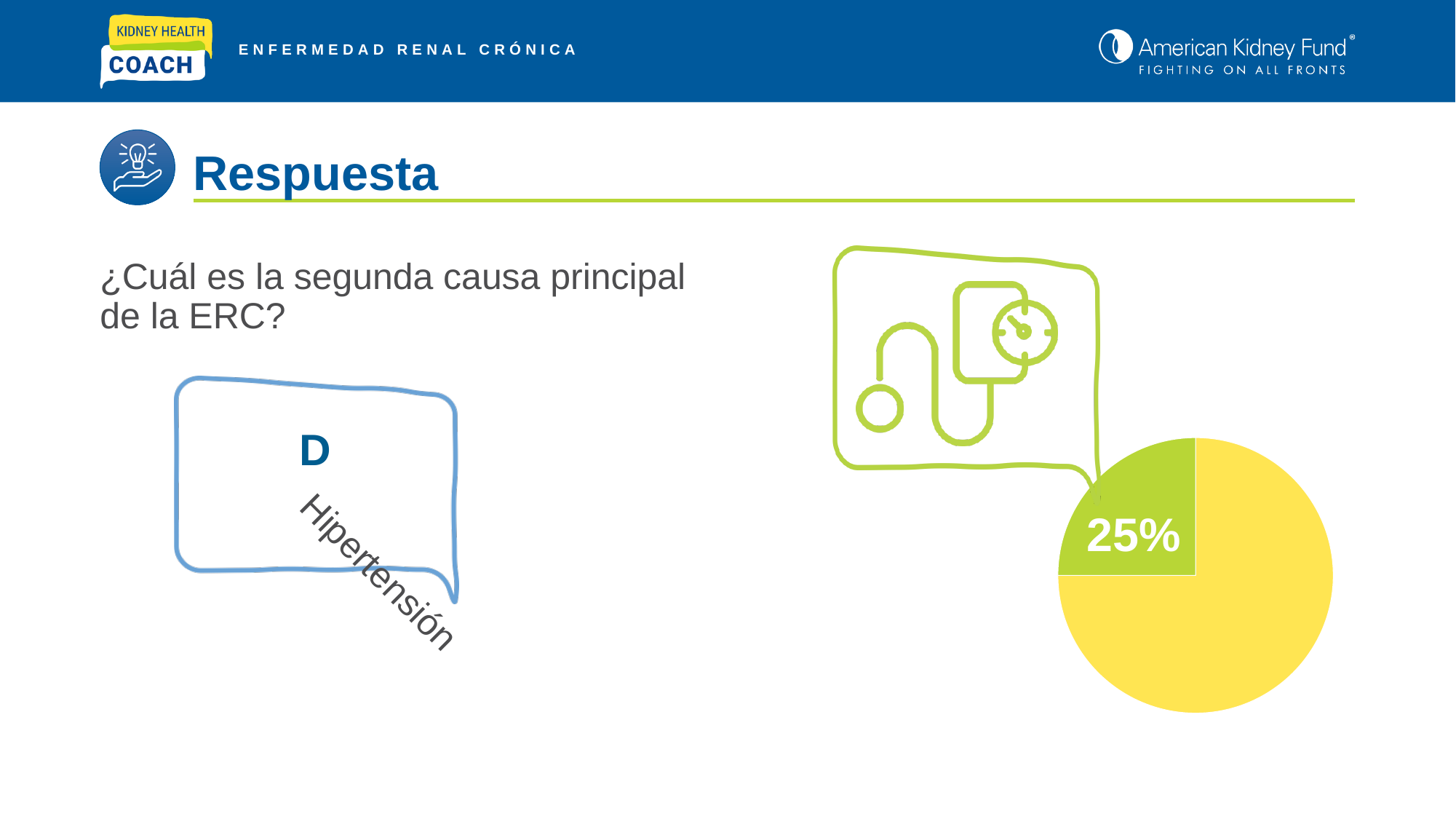
What is the only data label printed on the pie chart? 25% Which slice of the pie chart is larger, the green slice or the yellow slice? the yellow slice What kind of chart is shown on the right side of the slide? pie chart What share of the pie chart does the green slice represent? 25% How many slices does the pie chart have? 2 Which slice of the pie chart is the smallest? the green slice What colour is the slice labelled 25% in the pie chart? green